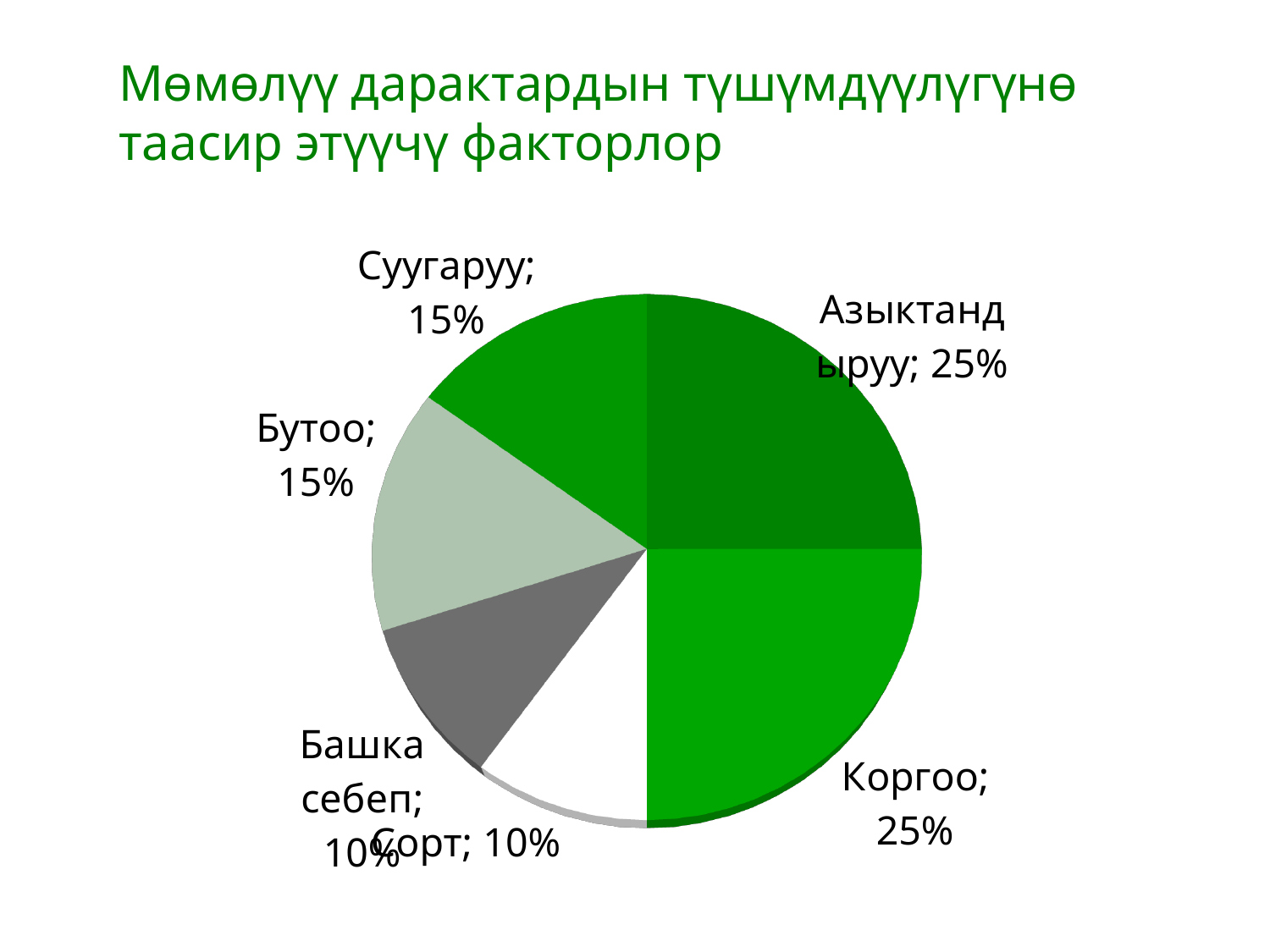
What percentage does the Сорт slice represent? 10% What percentage does the Азыктандыруу slice represent? 25% What is the title of the slide containing the pie chart? Мөмөлүү дарактардын түшүмдүүлүгүнө таасир этүүчү факторлор What is the difference in percentage points between the Азыктандыруу slice and the Сорт slice? 15 What percentage does the Суугаруу slice represent? 15% What is the difference in percentage points between the Суугаруу slice and the Башка себеп slice? 5 What percentage does the Бутоо slice represent? 15% What kind of chart is shown on the slide? Pie chart What percentage does the Башка себеп slice represent? 10% How many slices does the pie chart have? 6 What percentage does the Коргоо slice represent? 25% Which is larger, the Коргоо slice or the Бутоо slice? Коргоо